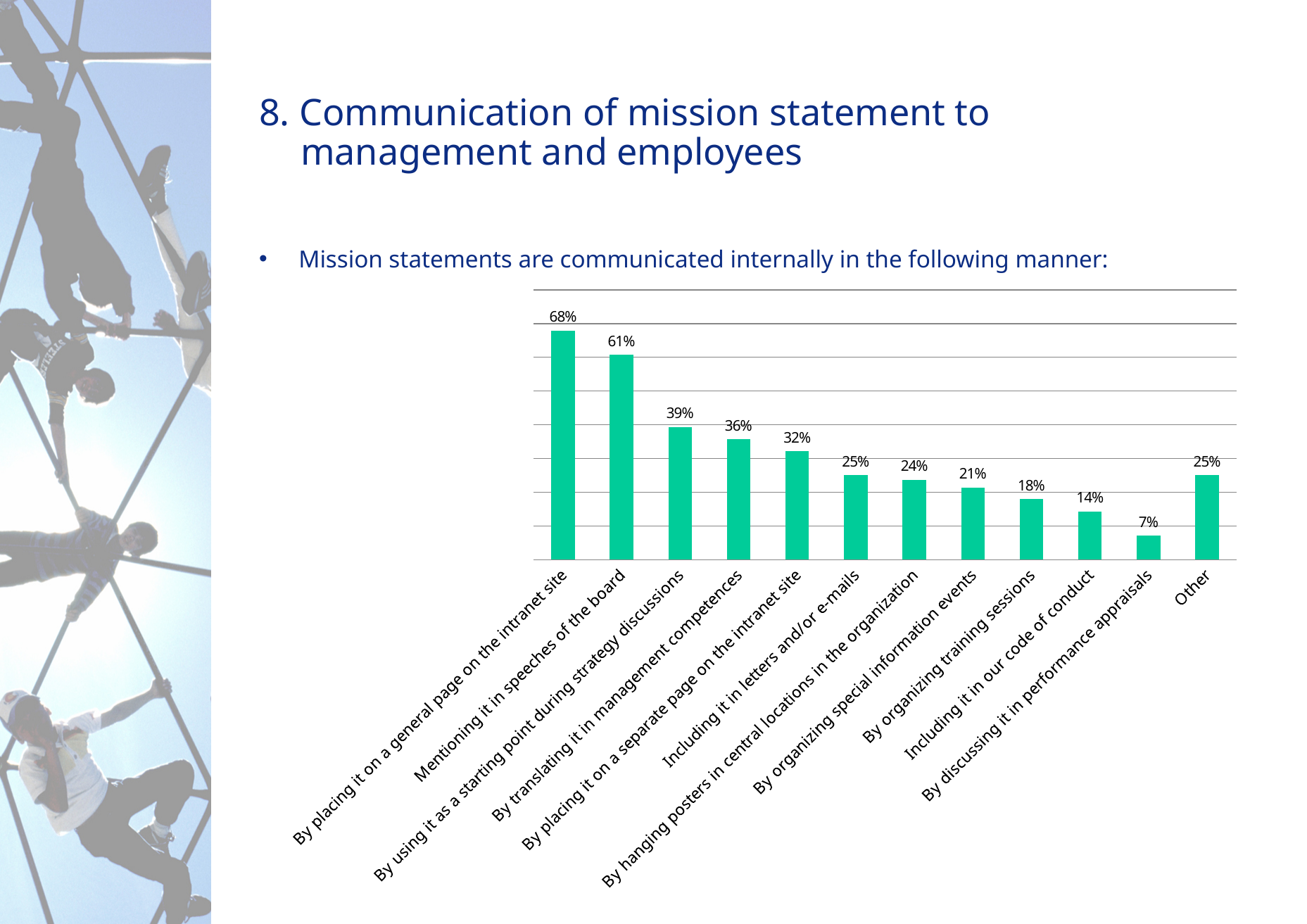
What is the difference between 'Including it in our code of conduct' and 'By discussing it in performance appraisals'? 7% What percentage is shown for 'Other'? 25% Which is larger: 'By using it as a starting point during strategy discussions' or 'By translating it in management competences'? By using it as a starting point during strategy discussions What kind of chart is shown on the slide? Bar chart How many categories are shown in the chart? 12 Which category has the lowest value? By discussing it in performance appraisals What is the difference between 'By placing it on a general page on the intranet site' and 'Mentioning it in speeches of the board'? 7% What percentage is shown for 'Mentioning it in speeches of the board'? 61% What percentage is shown for 'By placing it on a general page on the intranet site'? 68% What colour are the bars in the chart? Green What percentage is shown for 'By organizing training sessions'? 18% Which category has the highest value? By placing it on a general page on the intranet site